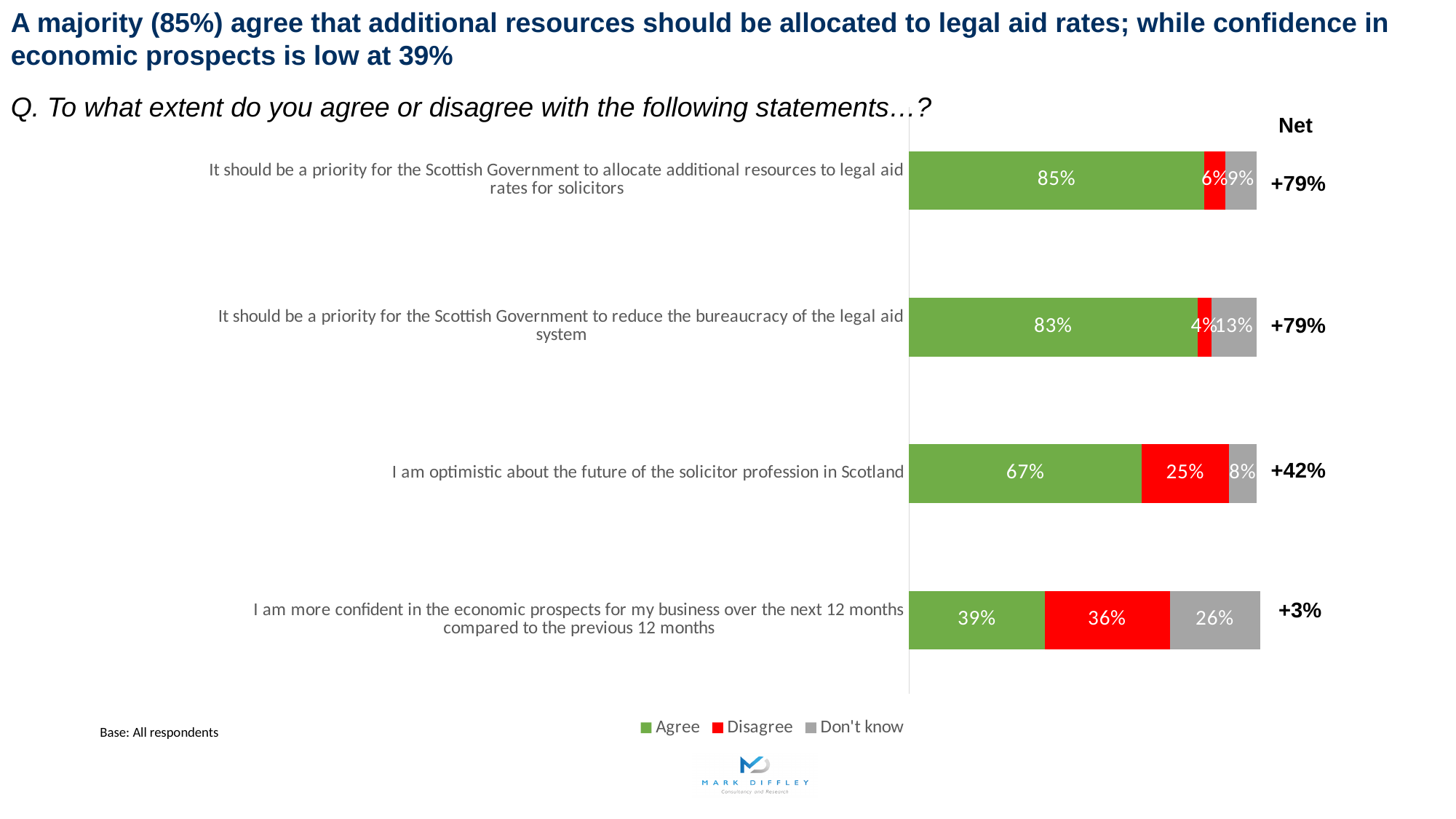
Which colour represents 'Disagree' in the chart? Red What is the difference between the Agree percentage for allocating additional resources to legal aid rates (85%) and the Agree percentage for being optimistic about the future of the solicitor profession (67%)? 18 percentage points Which statement has the highest Disagree percentage? I am more confident in the economic prospects for my business over the next 12 months compared to the previous 12 months What is the 'Don't know' percentage for the statement about being more confident in the economic prospects for my business over the next 12 months? 26% What kind of chart is shown on the slide? Stacked bar chart Which statement has the lowest Agree percentage? I am more confident in the economic prospects for my business over the next 12 months compared to the previous 12 months How many series does the legend list? 3 What percentage agree that it should be a priority for the Scottish Government to allocate additional resources to legal aid rates for solicitors? 85% What is the Net figure shown for the statement about reducing the bureaucracy of the legal aid system? +79% What percentage disagree with the statement 'I am optimistic about the future of the solicitor profession in Scotland'? 25% How many statements are plotted in the chart? 4 Which is larger: the Disagree percentage for the optimism statement or the Disagree percentage for the economic prospects statement? The economic prospects statement (36%)